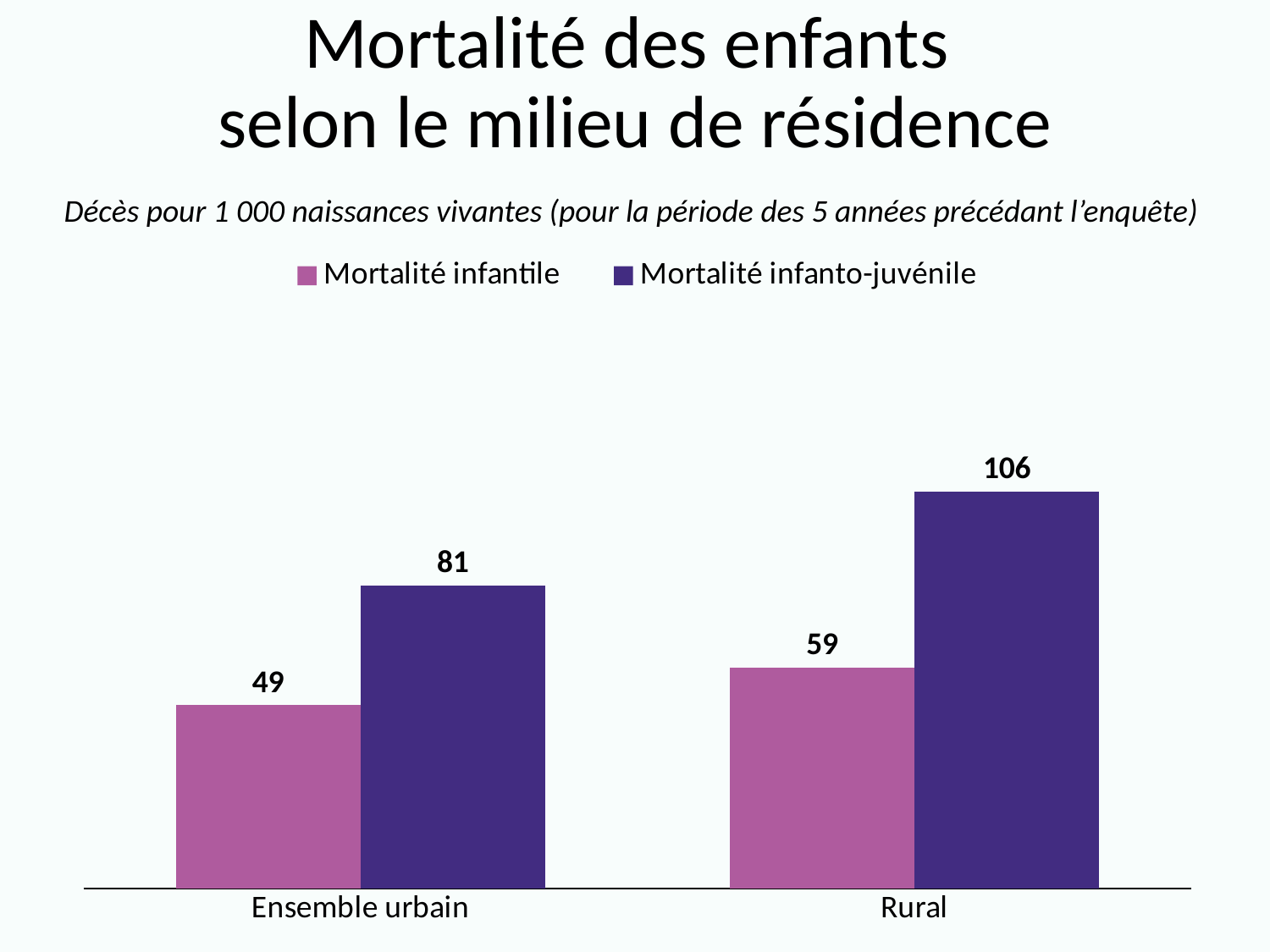
What is the Mortalité infantile value for Ensemble urbain? 49 Which is larger: Mortalité infantile for Rural or Mortalité infantile for Ensemble urbain? Rural What kind of chart is shown on the slide? Bar chart What is the difference between the Mortalité infanto-juvénile values for Rural and Ensemble urbain? 25 What is the Mortalité infanto-juvénile value for Ensemble urbain? 81 How many series does the legend list? 2 What is the Mortalité infanto-juvénile value for Rural? 106 Which category has the lowest Mortalité infantile value? Ensemble urbain How many categories are shown on the x axis? 2 Which category has the highest Mortalité infanto-juvénile value? Rural What is the difference between Mortalité infanto-juvénile and Mortalité infantile for Rural? 47 What is the Mortalité infantile value for Rural? 59